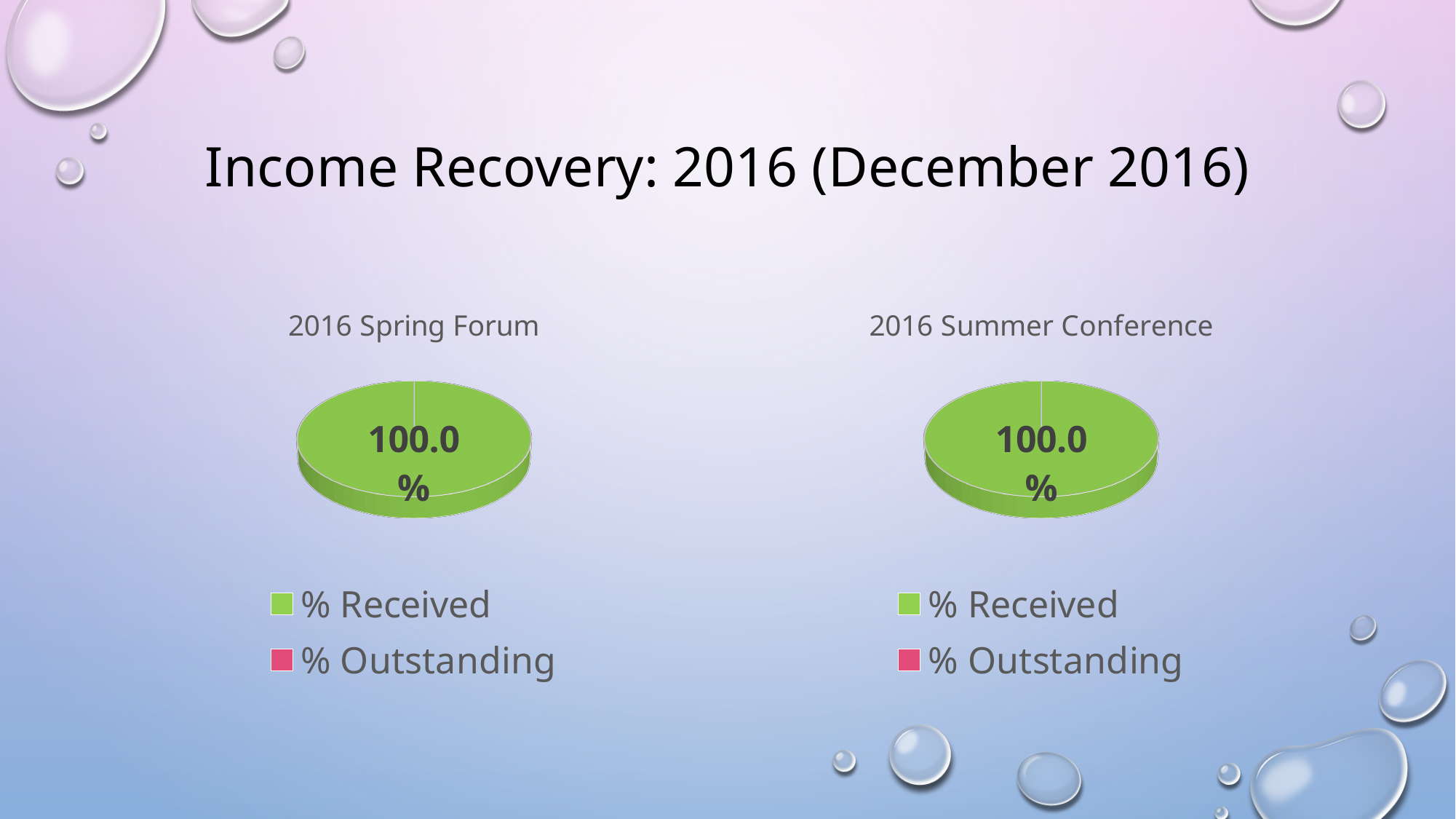
In the 2016 Summer Conference chart, which legend entry is shown in pink? % Outstanding In the 2016 Spring Forum chart, what percentage is shown for % Received? 100.0% Is the % Received value in the 2016 Summer Conference chart larger than, smaller than, or equal to the % Received value in the 2016 Spring Forum chart? Equal What kind of chart is the 2016 Spring Forum chart? Pie chart In the 2016 Spring Forum chart, which category makes up the largest share of the pie? % Received How many entries does the legend of the 2016 Summer Conference chart list? 2 What kind of chart is the 2016 Summer Conference chart? Pie chart In the 2016 Spring Forum chart, what share of the pie does % Received take? 100.0% In the 2016 Summer Conference chart, which category makes up the largest share of the pie? % Received What is the title of the chart on the left of the slide? 2016 Spring Forum In the 2016 Summer Conference chart, what percentage is shown for % Received? 100.0% How many entries does the legend of the 2016 Spring Forum chart list? 2